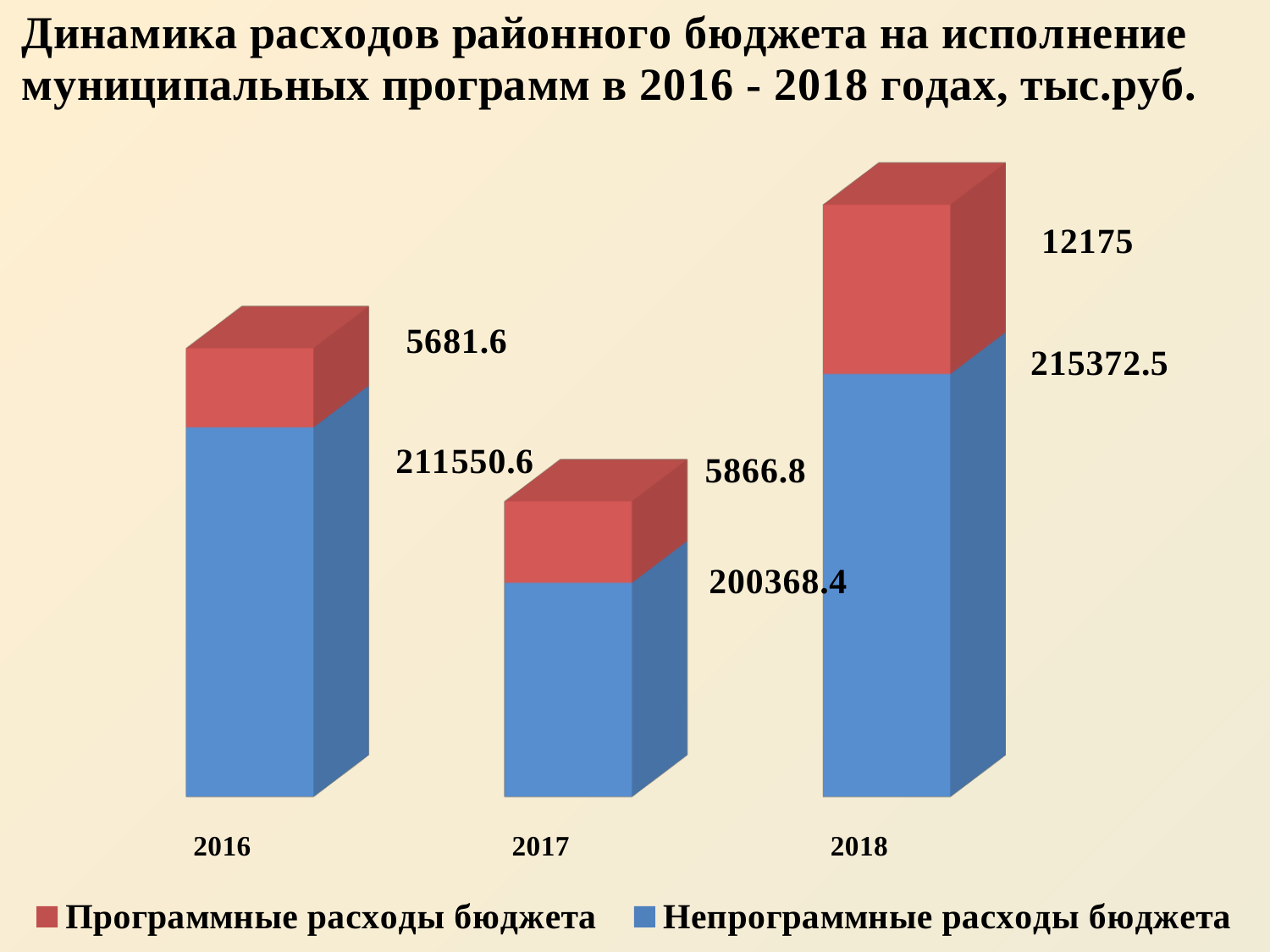
What is the value of Непрограммные расходы бюджета for 2018? 215372.5 What is the value of Программные расходы бюджета for 2016? 5681.6 In which year is Программные расходы бюджета the highest? 2018 In which year is Непрограммные расходы бюджета the lowest? 2017 What is the difference between Программные расходы бюджета in 2018 and in 2017? 6308.2 What type of chart is shown on the slide? Stacked bar chart What is the total of the stacked bar for 2017? 206235.2 What is the value of Непрограммные расходы бюджета for 2017? 200368.4 What is the difference between Непрограммные расходы бюджета in 2016 and in 2017? 11182.2 What is the value of Программные расходы бюджета for 2018? 12175 How many years are shown on the x axis? 3 Which is larger: Непрограммные расходы бюджета in 2018 or in 2016? 2018